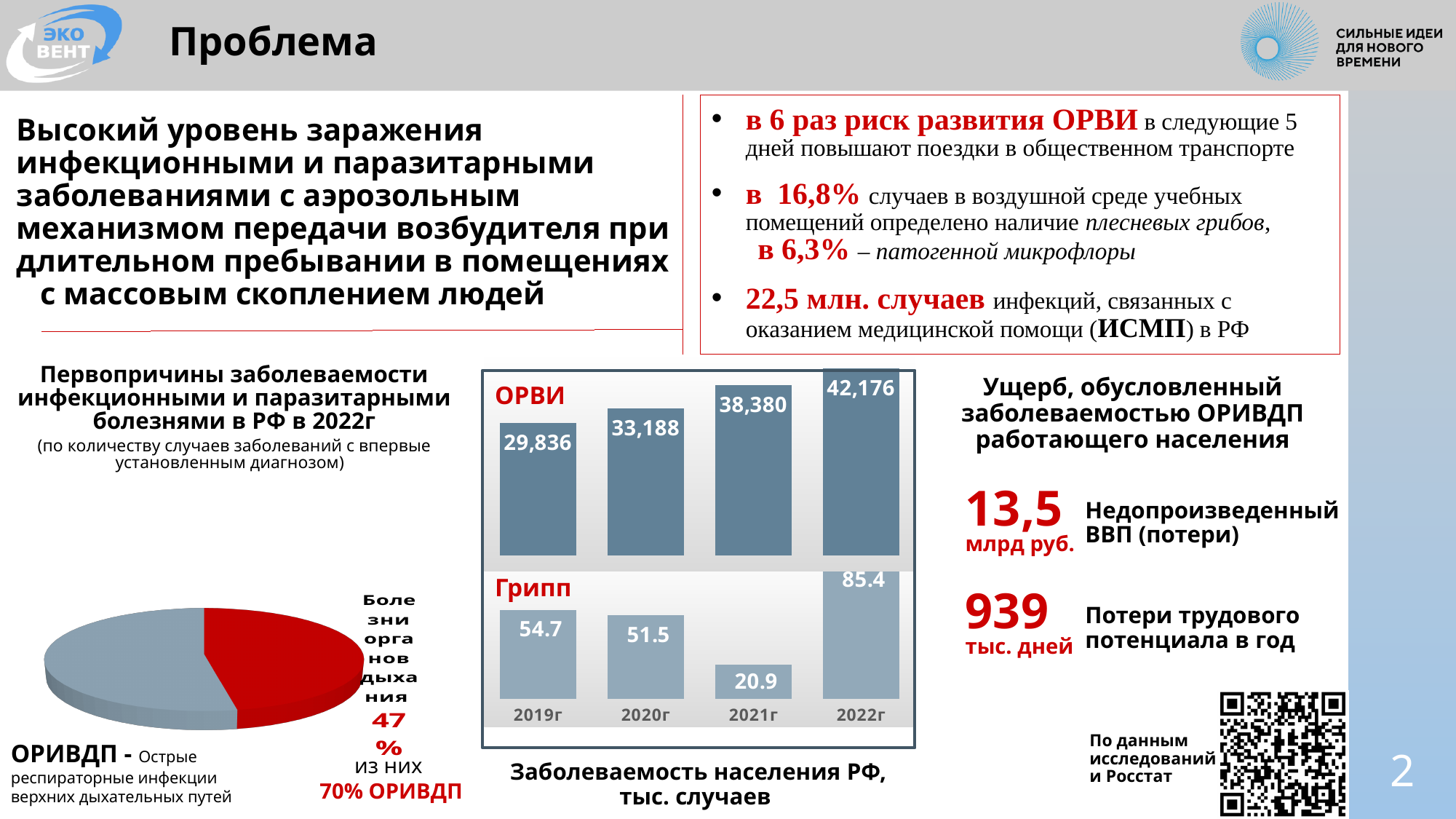
In the bar chart 'Заболеваемость населения РФ, тыс. случаев', what is the difference between the Грипп values for 2022г and 2021г? 64.5 In the pie chart on the left of the slide, what share is labelled for 'Болезни органов дыхания'? 47% In the bar chart 'Заболеваемость населения РФ, тыс. случаев', what is the Грипп value for 2022г? 85.4 In the bar chart 'Заболеваемость населения РФ, тыс. случаев', do the ОРВИ values rise or fall from 2019г to 2022г? rise In the bar chart 'Заболеваемость населения РФ, тыс. случаев', which year has the larger Грипп value, 2019г or 2020г? 2019г What kind of chart is the chart titled 'Заболеваемость населения РФ, тыс. случаев'? bar chart In the bar chart 'Заболеваемость населения РФ, тыс. случаев', what is the difference between the ОРВИ values for 2022г and 2019г? 12,340 In the bar chart 'Заболеваемость населения РФ, тыс. случаев', how many years are shown on the x axis? 4 In the bar chart 'Заболеваемость населения РФ, тыс. случаев', what is the Грипп value for 2021г? 20.9 In the bar chart 'Заболеваемость населения РФ, тыс. случаев', what is the ОРВИ value for 2022г? 42,176 In the bar chart 'Заболеваемость населения РФ, тыс. случаев', which year has the highest ОРВИ value? 2022г In the bar chart 'Заболеваемость населения РФ, тыс. случаев', which year has the lowest Грипп value? 2021г